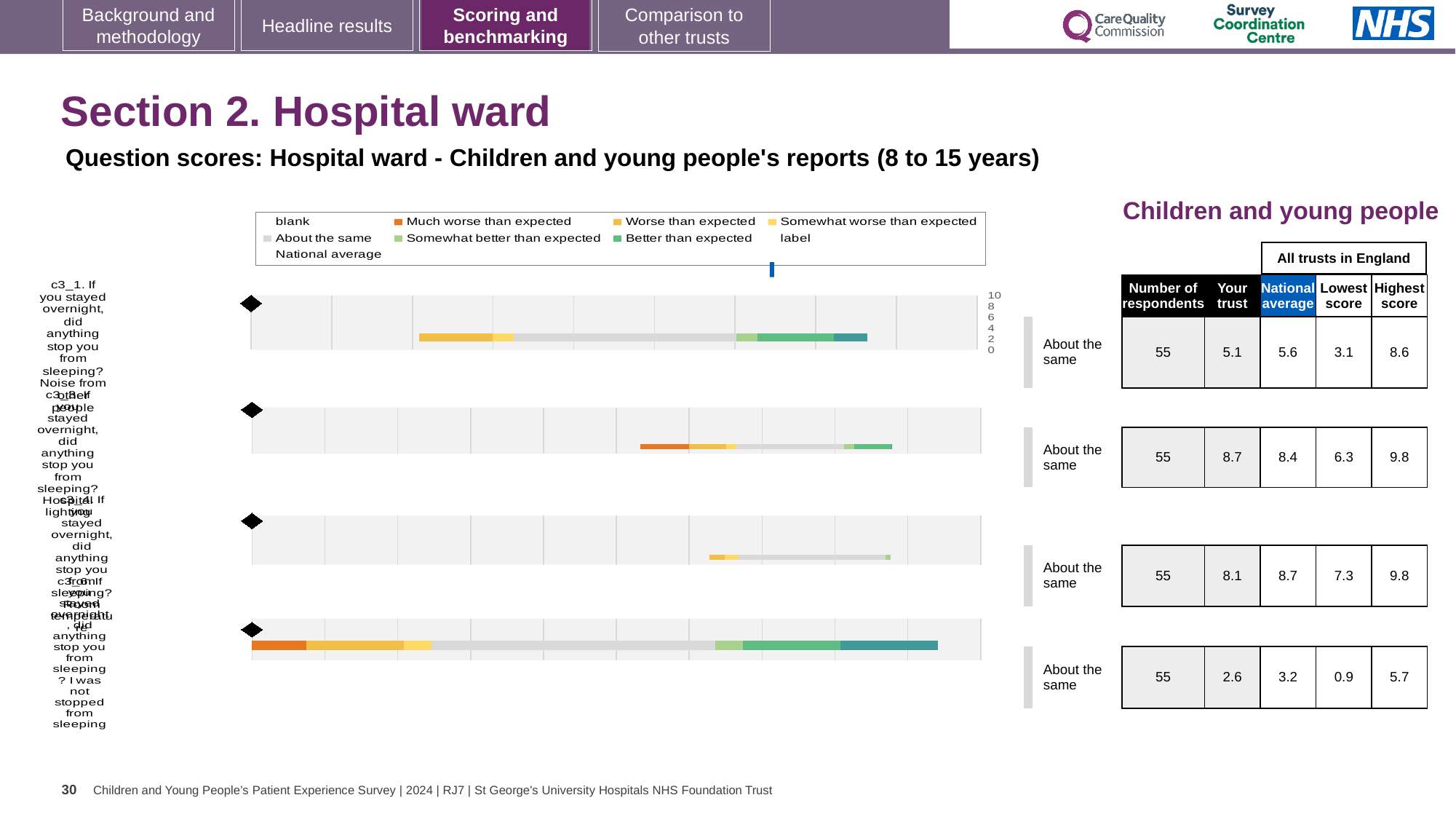
What benchmark label is shown next to each of the four charts? About the same How many entries does the legend above the charts list? 9 In the table to the right of the charts, what is the number of respondents for the first row? 55 In the table to the right of the charts, what is the highest score in the last row? 5.7 What is the highest tick value shown on the axis to the right of the first chart? 10 In the second row of the table, which is larger: the 'Your trust' score or the national average? Your trust In the table to the right of the charts, what is the 'Your trust' score in the first row? 5.1 How many separate benchmark bar charts are shown on the slide? 4 In the second row of the table, what is the difference between the 'Your trust' score (8.7) and the national average (8.4)? 0.3 In the table to the right of the charts, what is the lowest score in the second row? 6.3 What colour does the legend use for 'Much worse than expected'? orange What kind of chart is used for the four benchmark charts on the slide? bar chart